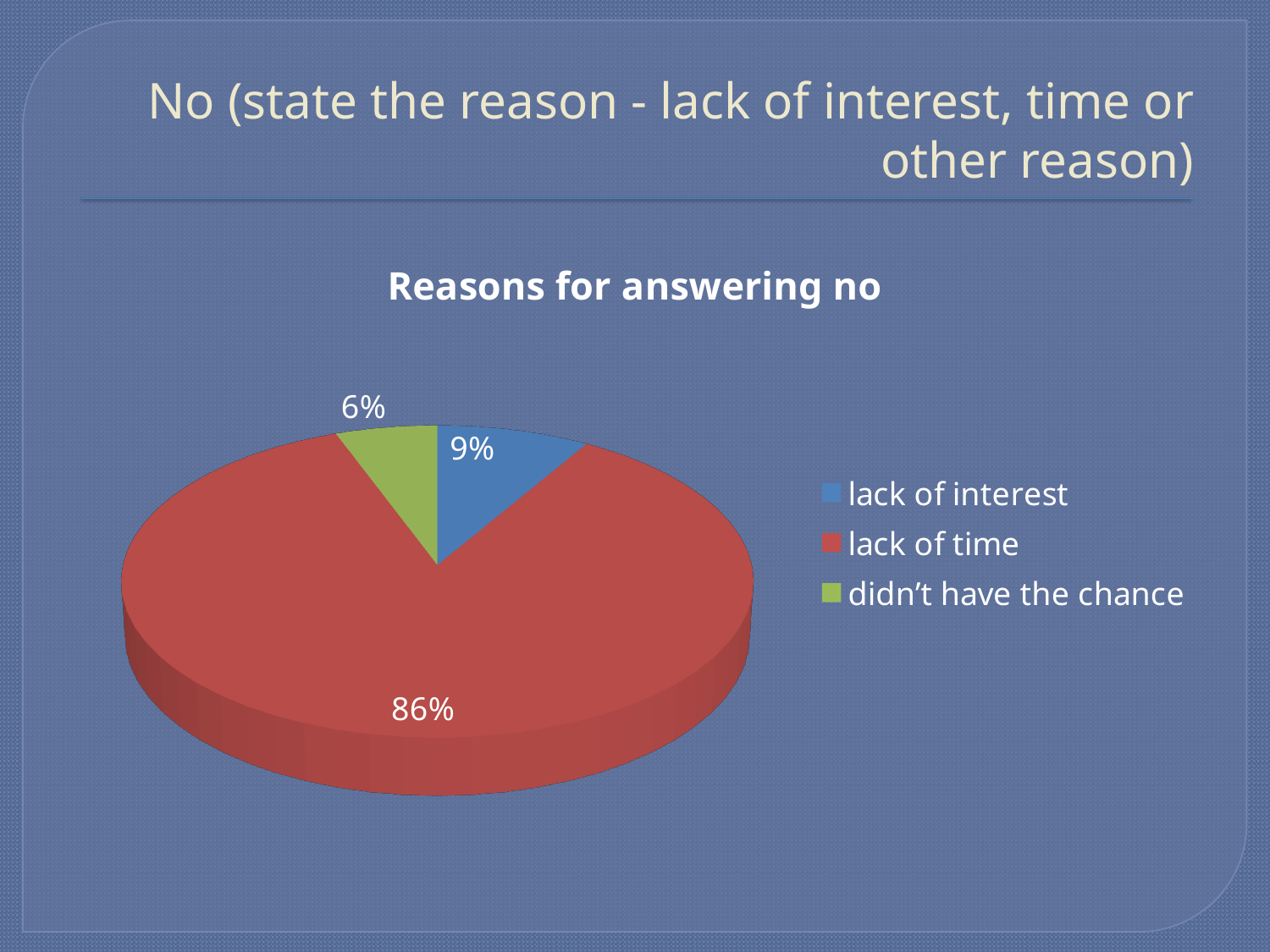
What share of the pie is 'lack of interest'? 9% Which colour represents 'lack of time' in the pie chart? red What share of the pie is 'didn't have the chance'? 6% How many categories does the pie chart show? 3 What is the difference in percentage points between 'lack of time' and 'lack of interest'? 77 What is the difference in percentage points between 'lack of interest' and 'didn't have the chance'? 3 Which reason has the smallest share of the pie? didn't have the chance What kind of chart is shown on the slide? pie chart What is the title of the chart? Reasons for answering no What share of the pie is 'lack of time'? 86% Which reason has the largest share of the pie? lack of time Which is larger, the share for 'lack of interest' or for 'didn't have the chance'? lack of interest